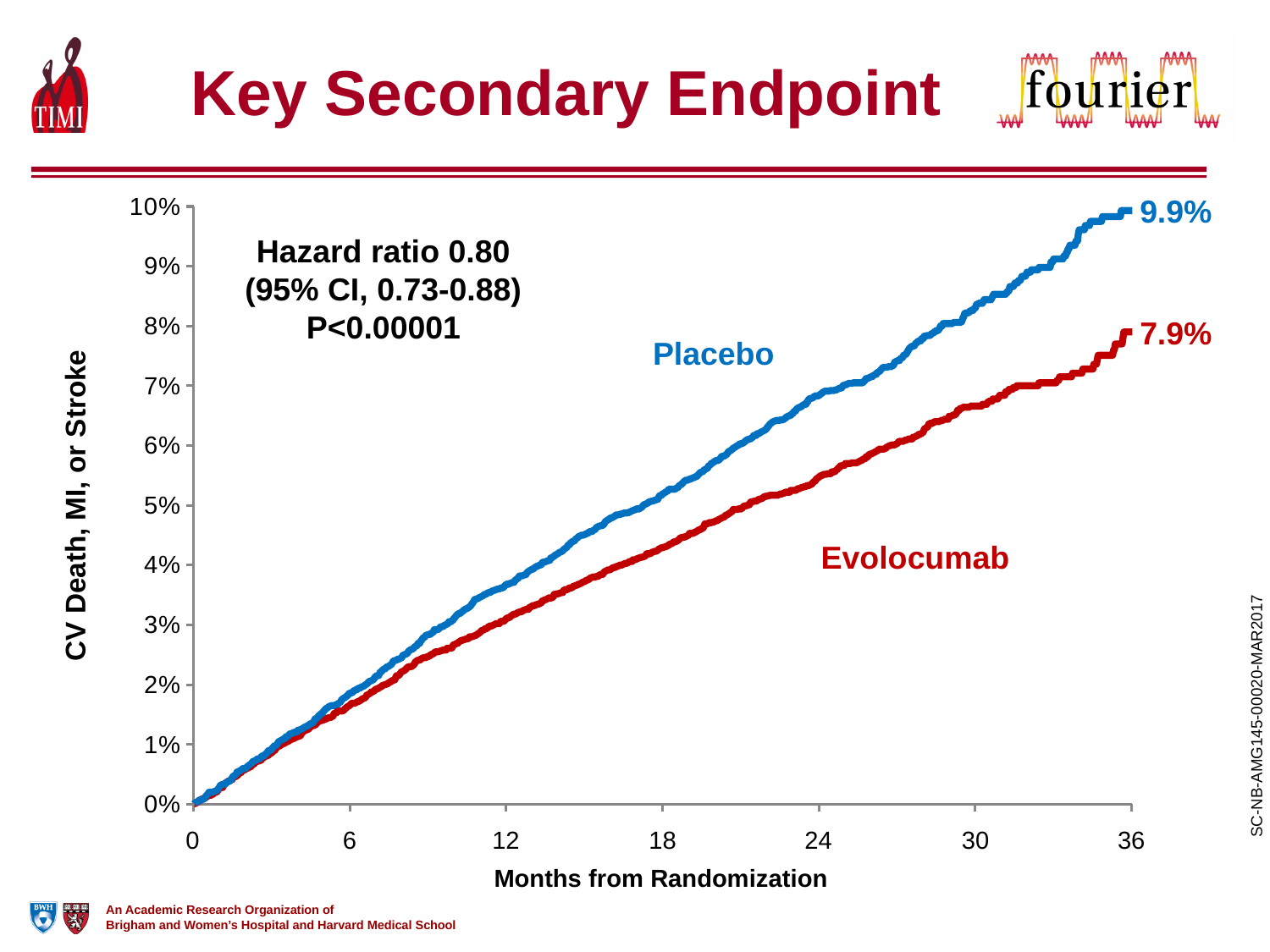
How many curves are plotted on the chart? 2 Is the Placebo curve at 24 months greater or less than 5%? greater What is the label of the y axis? CV Death, MI, or Stroke Is the Evolocumab curve at 12 months greater or less than 4%? less What is the final value shown for the Placebo curve at 36 months? 9.9% What is the final value shown for the Evolocumab curve at 36 months? 7.9% What hazard ratio is printed on the chart? 0.80 What kind of chart is shown on the slide? Line chart Is the Evolocumab curve at 24 months greater or less than 6%? less Which group has the higher event rate at 36 months, Placebo or Evolocumab? Placebo Do the curves rise or fall as months from randomization increase? Rise What is the difference between the Placebo and Evolocumab values at 36 months? 2.0%